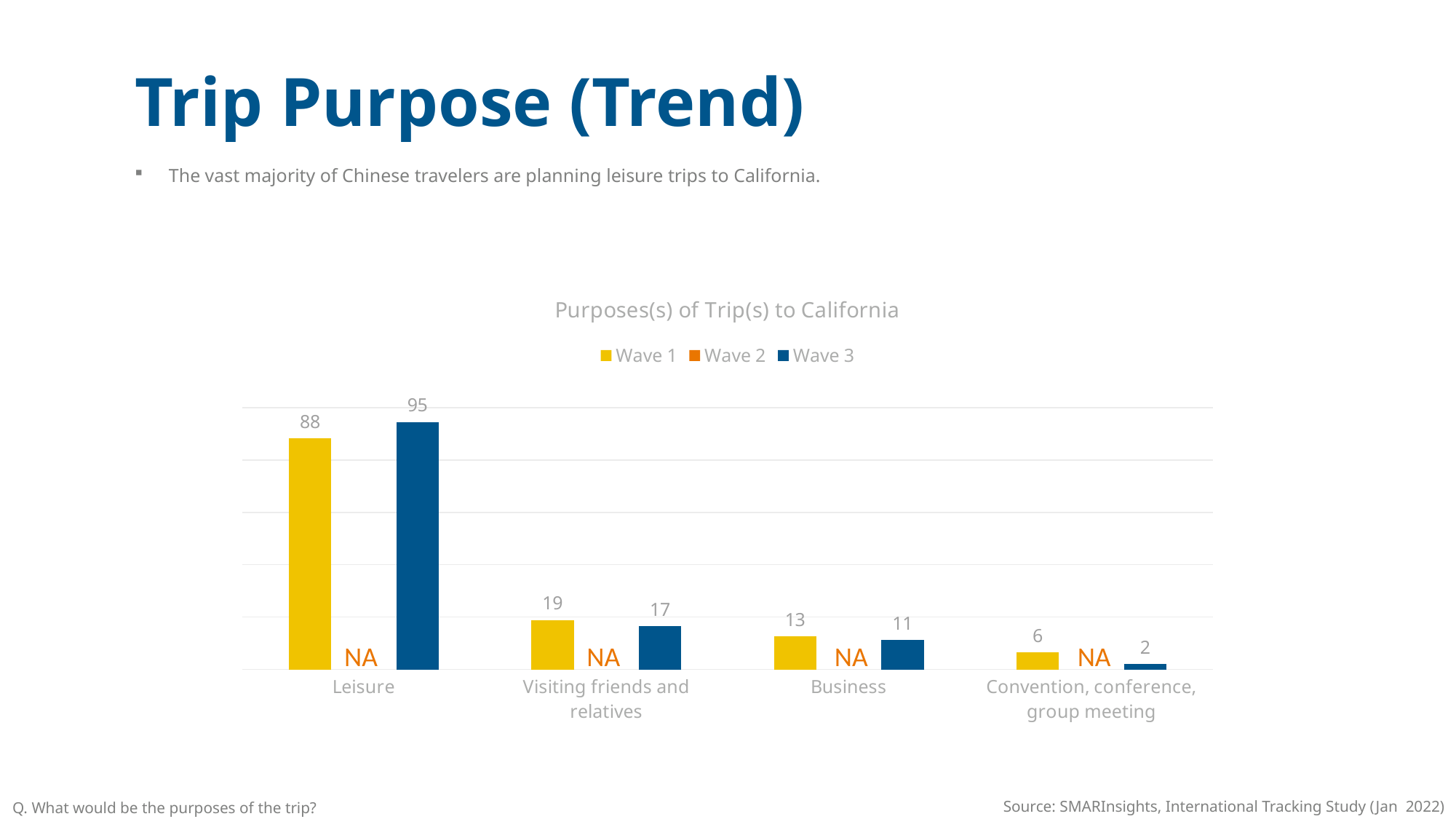
What kind of chart is shown? Bar chart How many categories are shown on the x axis? 4 Which category has the highest Wave 3 value? Leisure What is the Wave 3 value for Leisure? 95 Which is larger for Business: the Wave 1 value or the Wave 3 value? Wave 1 Which category has the lowest Wave 1 value? Convention, conference, group meeting What is the difference between the Wave 3 and Wave 1 values for Leisure? 7 What is the Wave 3 value for Visiting friends and relatives? 17 What is the Wave 1 value for Leisure? 88 What is the Wave 1 value for Business? 13 How many series does the legend list? 3 What is the Wave 3 value for Convention, conference, group meeting? 2